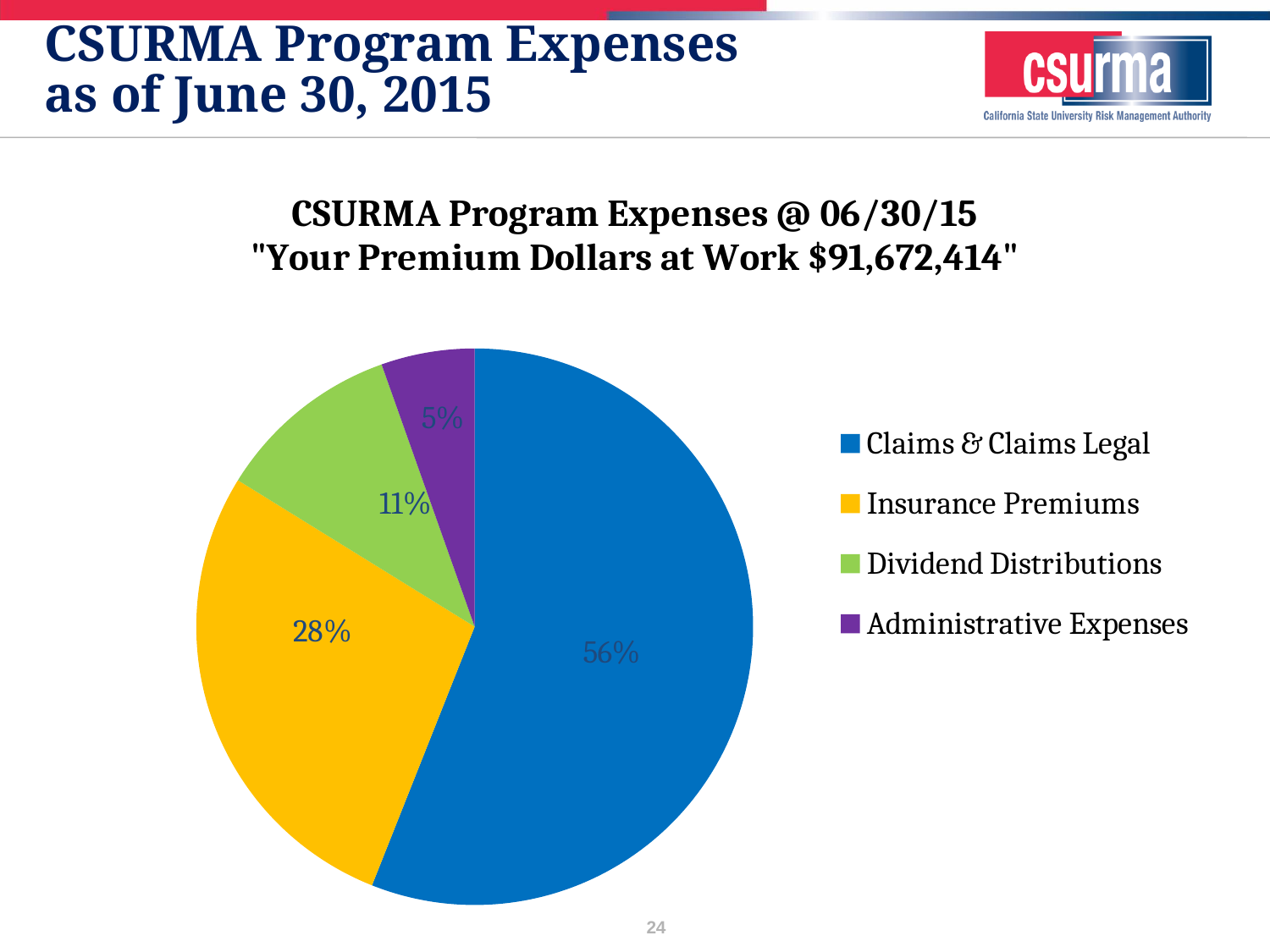
What kind of chart is shown on the slide? pie chart What share of the pie does Dividend Distributions represent? 11% What colour is the slice for Insurance Premiums? yellow Which category has the largest slice of the pie? Claims & Claims Legal What share of the pie does Insurance Premiums represent? 28% What is the difference in percentage points between Claims & Claims Legal and Insurance Premiums? 28 What is the title of the chart? CSURMA Program Expenses @ 06/30/15 "Your Premium Dollars at Work $91,672,414" Which is larger, the share for Dividend Distributions or the share for Administrative Expenses? Dividend Distributions Which category has the smallest slice of the pie? Administrative Expenses How many categories does the pie chart show? 4 What share of the pie does Claims & Claims Legal represent? 56%